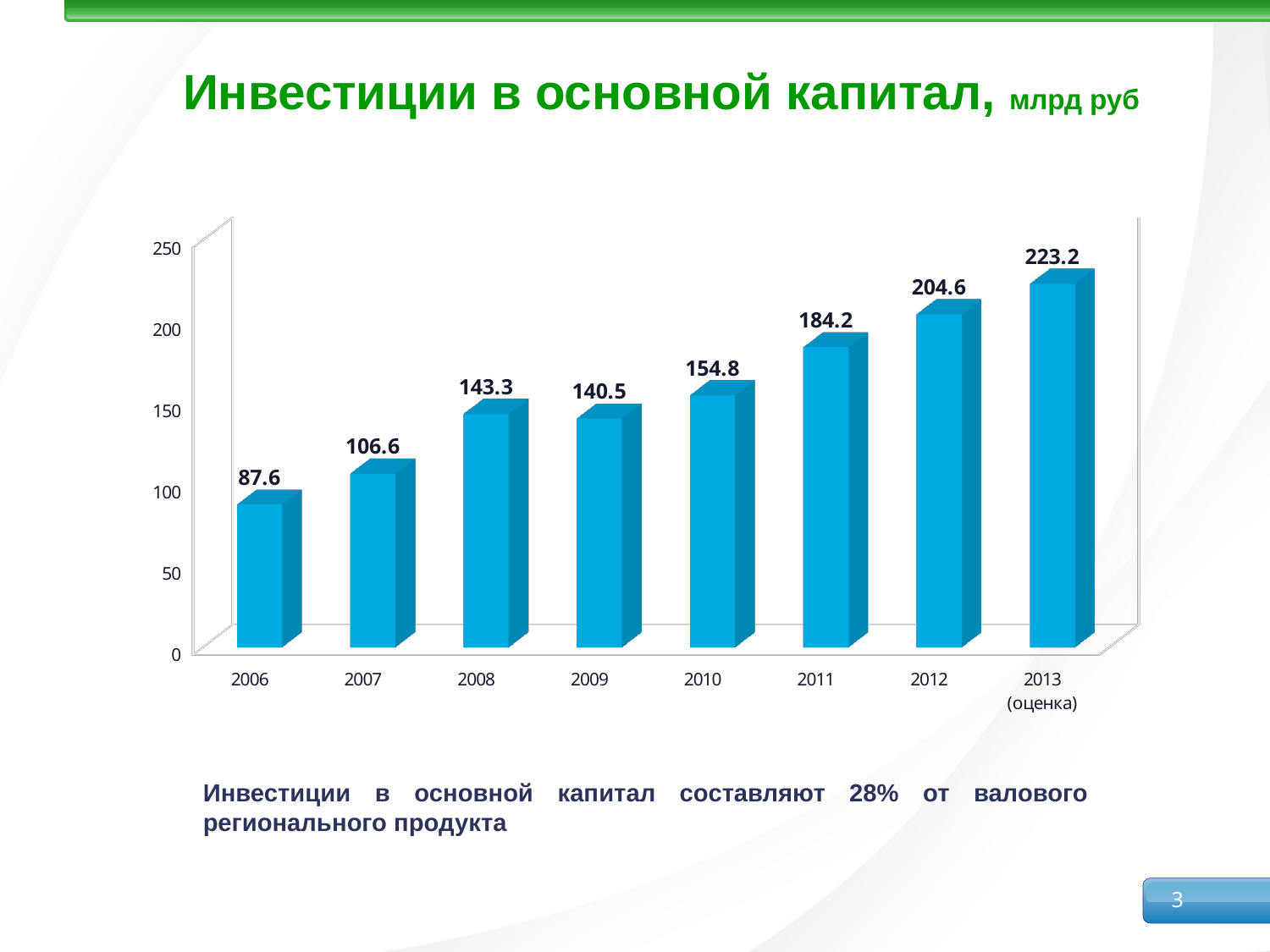
What is the title of the chart? Инвестиции в основной капитал, млрд руб What is the difference between the values for 2008 and 2009? 2.8 What is the value for 2013 (оценка)? 223.2 What is the difference between the values for 2012 and 2011? 20.4 Which year has the lowest value? 2006 Which is larger, the value for 2008 or the value for 2009? 2008 How many years are shown on the x axis? 8 What is the value for 2006? 87.6 What is the value for 2010? 154.8 Which year has the highest value? 2013 (оценка) What kind of chart is shown on the slide? bar chart Is the value for 2011 greater or less than 150? greater